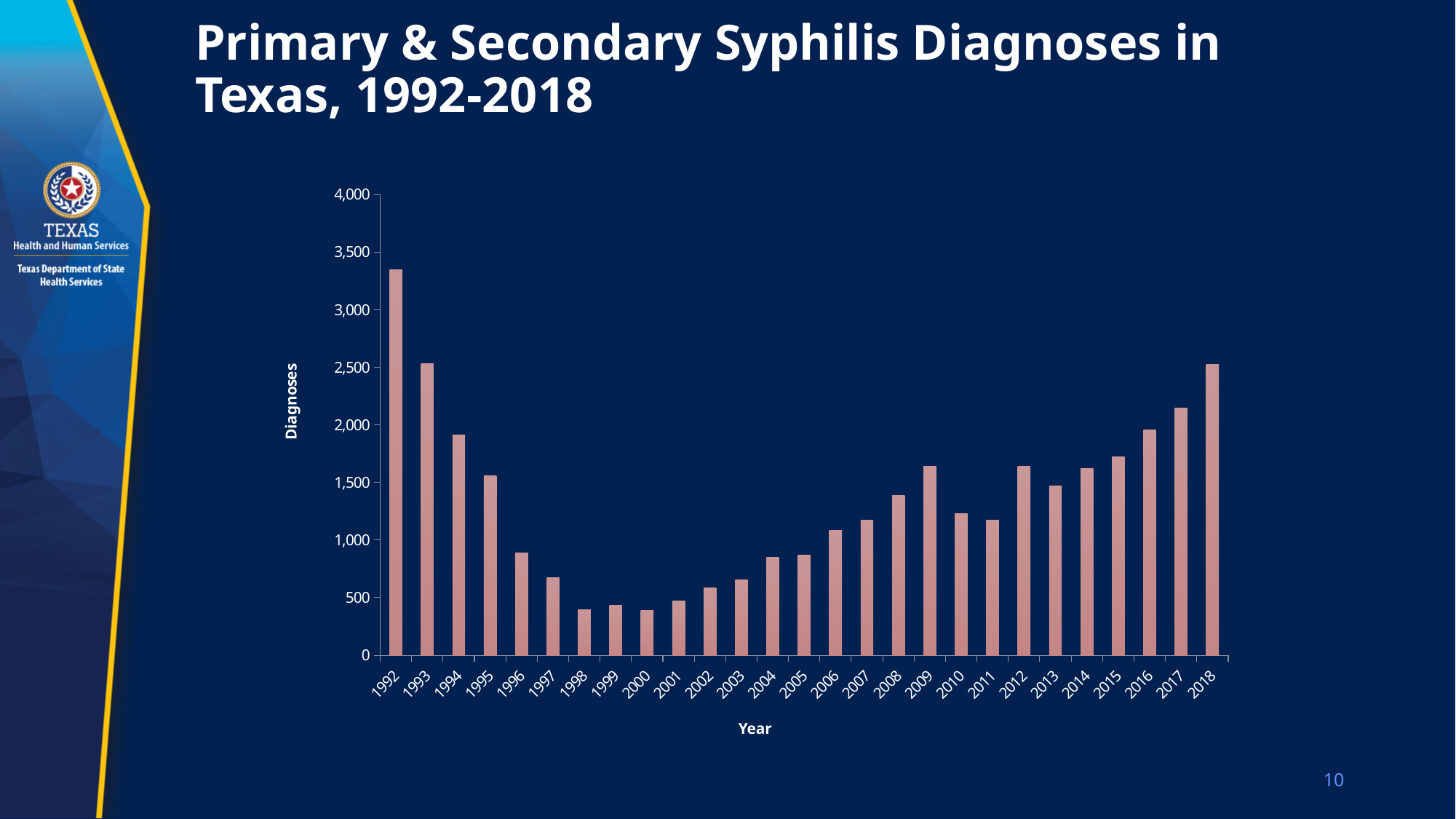
Is the value for 2000 greater or less than 500? less What is the label of the y axis? Diagnoses What kind of chart is shown on the slide? bar chart How many years are plotted on the x axis? 27 Is the value for 2009 greater or less than 1,500? greater Is the value for 2017 greater or less than 2,000? greater Which year has the highest number of diagnoses? 1992 Do the diagnoses rise or fall from 1992 to 2000? fall Which year has more diagnoses, 2009 or 2010? 2009 Which year has more diagnoses, 1992 or 2018? 1992